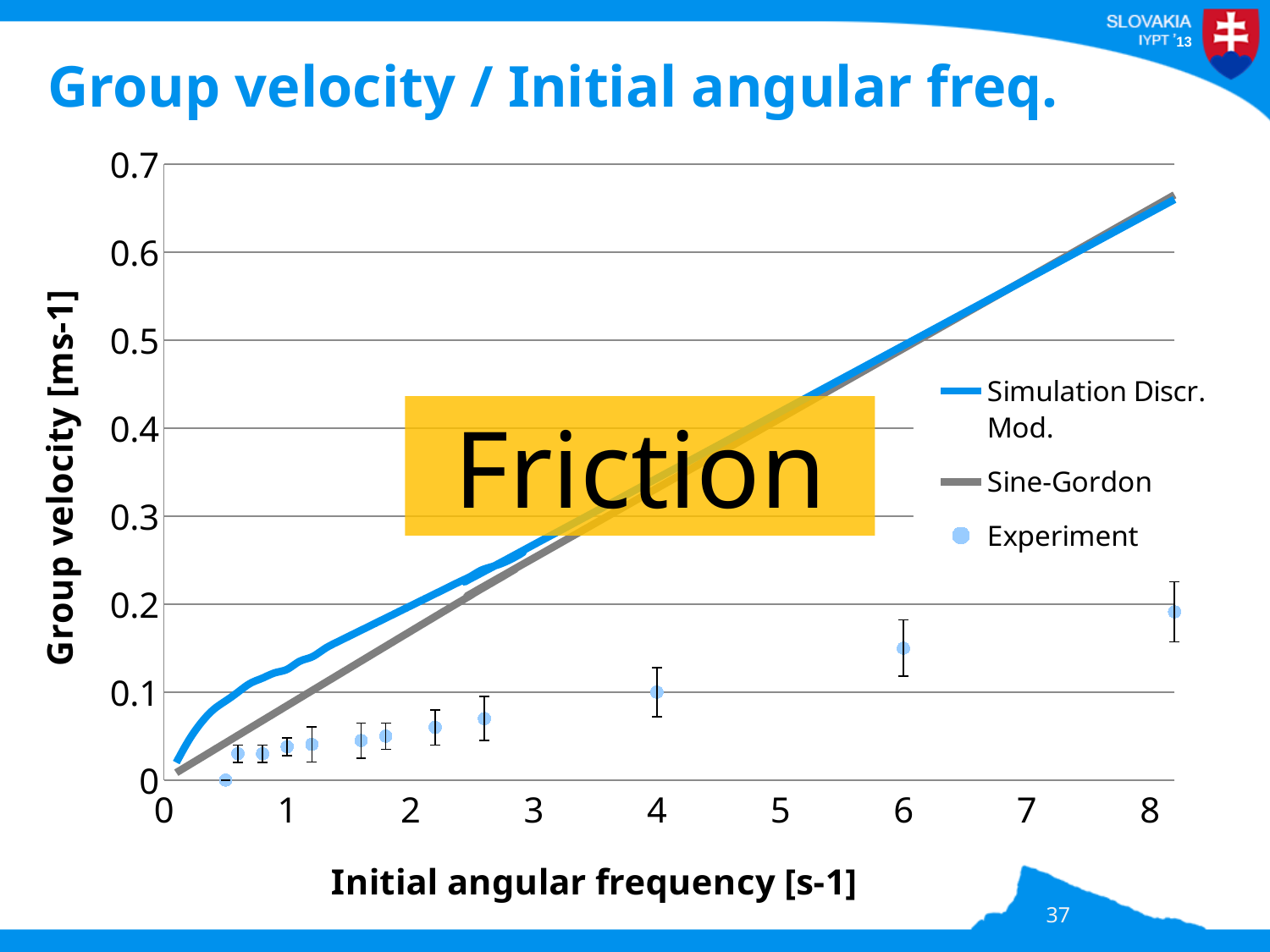
At an initial angular frequency of 1, which series has the larger group velocity: Simulation Discr. Mod. or Sine-Gordon? Simulation Discr. Mod. What is the title of the chart? Group velocity / Initial angular freq. Is the Experiment value at an initial angular frequency of 6 greater or less than 0.1? greater What kind of chart is shown on the slide? line chart with scatter points How many Experiment data points are plotted on the chart? 12 Do the Experiment values rise or fall as the initial angular frequency increases? rise Is the Simulation Discr. Mod. value at an initial angular frequency of 8 greater or less than 0.6? greater At an initial angular frequency of 6, which series has the larger group velocity: Simulation Discr. Mod. or Experiment? Simulation Discr. Mod. How many series does the legend list? 3 Is the Experiment value at an initial angular frequency of 6 greater or less than 0.2? less What label is on the vertical axis of the chart? Group velocity [ms-1]